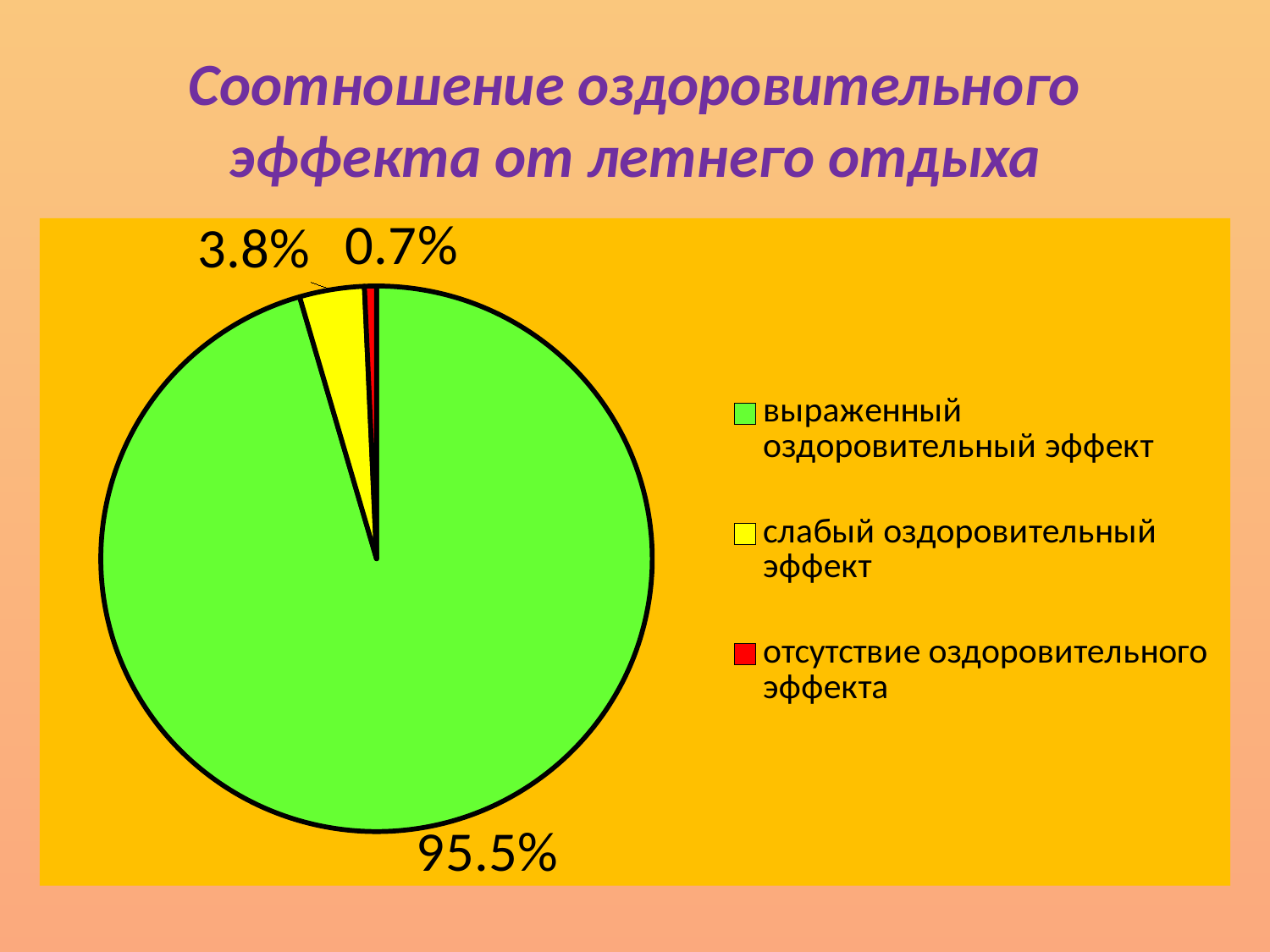
Which category has the smallest slice of the pie? отсутствие оздоровительного эффекта Which category has the largest slice of the pie? выраженный оздоровительный эффект Which is larger: the slice for "слабый оздоровительный эффект" or the slice for "отсутствие оздоровительного эффекта"? слабый оздоровительный эффект What share of the pie is labelled "слабый оздоровительный эффект"? 3.8% How many entries does the legend list? 3 How many slices does the pie chart have? 3 What is the title of the slide containing the chart? Соотношение оздоровительного эффекта от летнего отдыха What share of the pie is labelled "отсутствие оздоровительного эффекта"? 0.7% What kind of chart is shown on the slide? pie chart What colour is the slice for "отсутствие оздоровительного эффекта"? red What share of the pie is labelled "выраженный оздоровительный эффект"? 95.5% What is the difference in percentage points between "слабый оздоровительный эффект" and "отсутствие оздоровительного эффекта"? 3.1